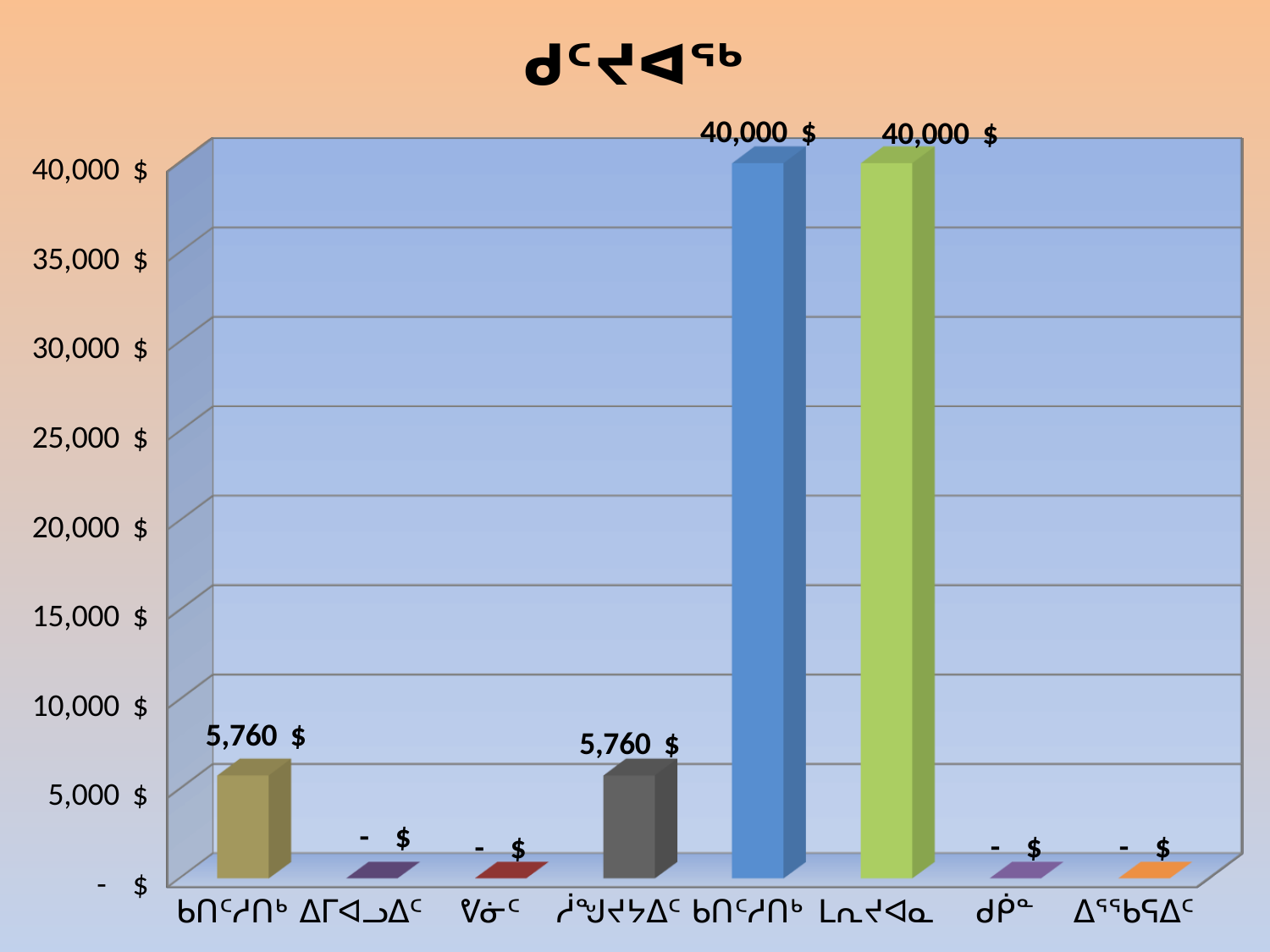
What is the value of the first (leftmost, olive-coloured) bar? 5,760 $ What is the value of the fourth bar (the dark grey one)? 5,760 $ Is the value of the blue bar greater or less than 35,000 $? greater How many categories on the chart show a value of "- $" (zero)? 4 Which is larger, the value of the green bar or the value of the dark grey bar? the green bar How many categories are shown along the x axis of the chart? 8 What is the difference between the value of the blue bar and the value of the leftmost olive bar? 34,240 $ What is the value of the sixth bar (the green one)? 40,000 $ How many bars on the chart have a value of 40,000 $? 2 What is the title of the chart? ᑯᑦᔪᐊᖅ What kind of chart is shown on the slide? bar chart What is the value of the fifth bar (the blue one)? 40,000 $